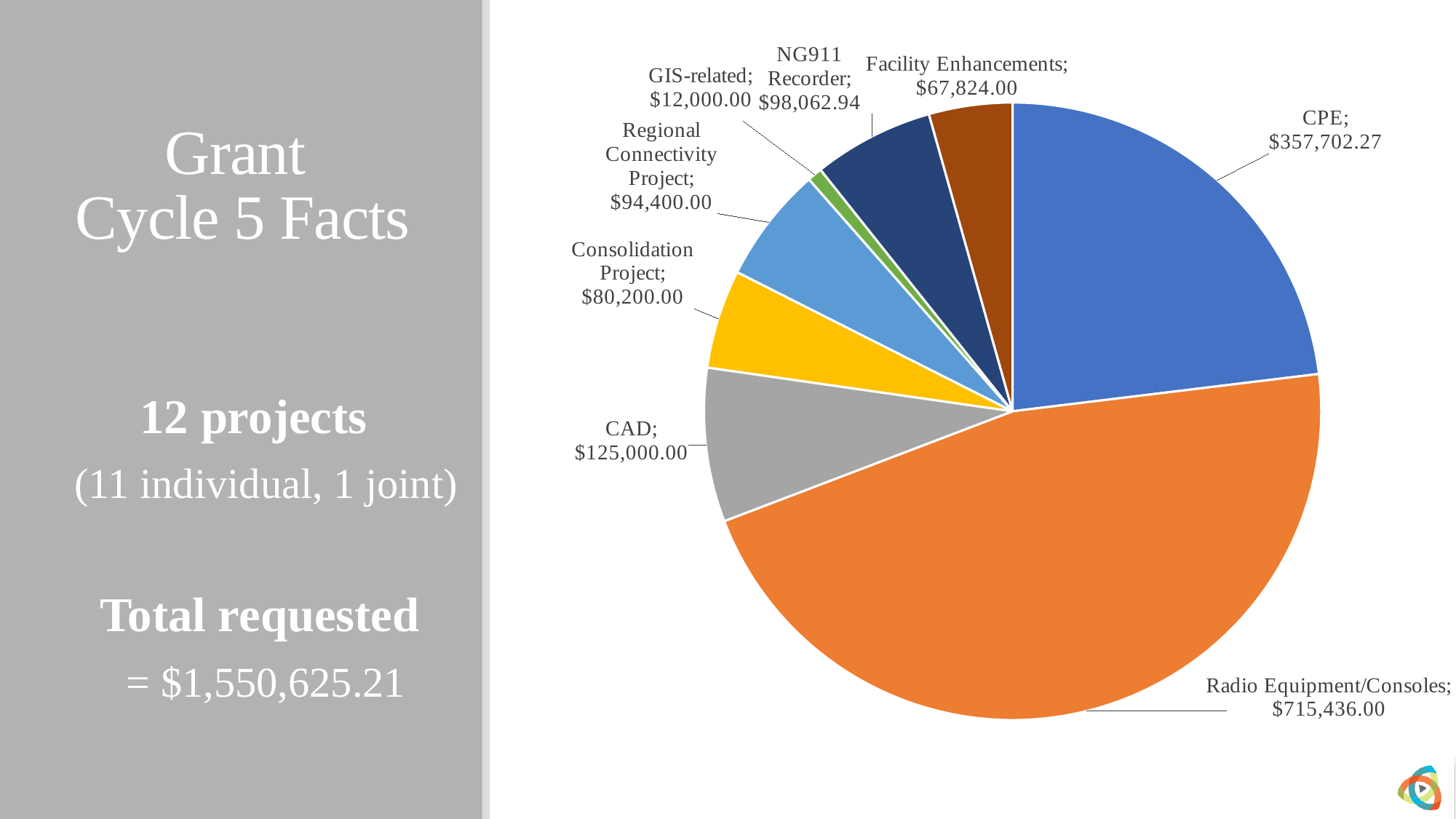
Which category has the smallest slice of the pie? GIS-related What is the value for the Consolidation Project? $80,200.00 Which is larger, Regional Connectivity Project or Facility Enhancements? Regional Connectivity Project What colour is the Radio Equipment/Consoles slice? Orange What is the value for CPE? $357,702.27 What is the value for Radio Equipment/Consoles? $715,436.00 What is the value for the NG911 Recorder slice? $98,062.94 Which category has the largest slice of the pie? Radio Equipment/Consoles How many slices does the pie chart have? 8 What kind of chart is shown on the slide? Pie chart What is the difference between Radio Equipment/Consoles and CPE? $357,733.73 What is the difference between CAD and the Consolidation Project? $44,800.00